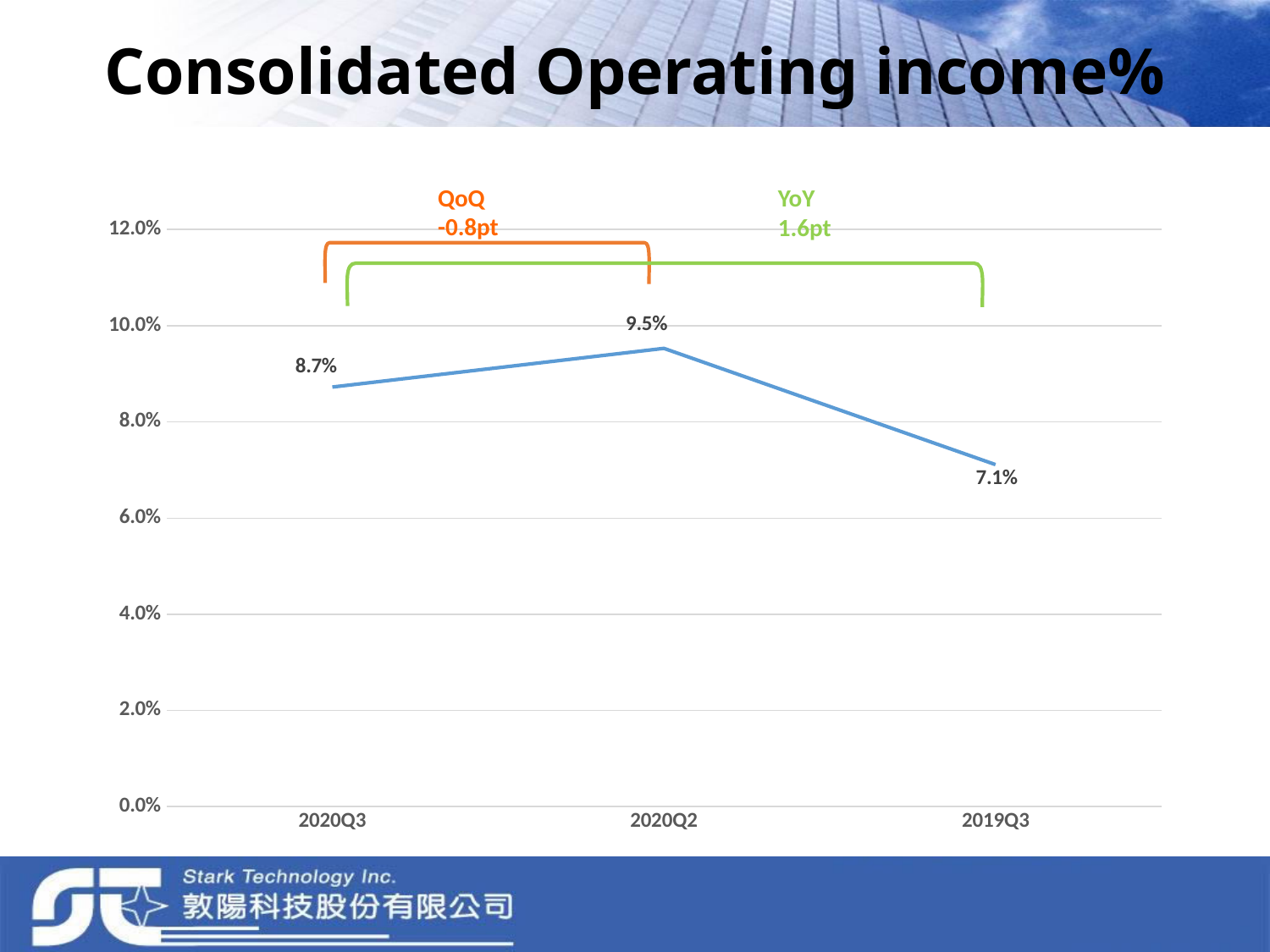
What is the consolidated operating income % for 2020Q3? 8.7% Which period has the highest operating income %? 2020Q2 What is the difference in operating income % between 2020Q2 and 2020Q3? 0.8pt What kind of chart is shown on the slide? line chart Which is larger, the operating income % for 2020Q3 or for 2019Q3? 2020Q3 How many periods are plotted on the chart? 3 What is the QoQ change in operating income % shown on the chart? -0.8pt What is the consolidated operating income % for 2020Q2? 9.5% Is the value for 2019Q3 greater or less than 8.0%? less What is the consolidated operating income % for 2019Q3? 7.1% Which period has the lowest operating income %? 2019Q3 What is the difference in operating income % between 2020Q3 and 2019Q3? 1.6pt